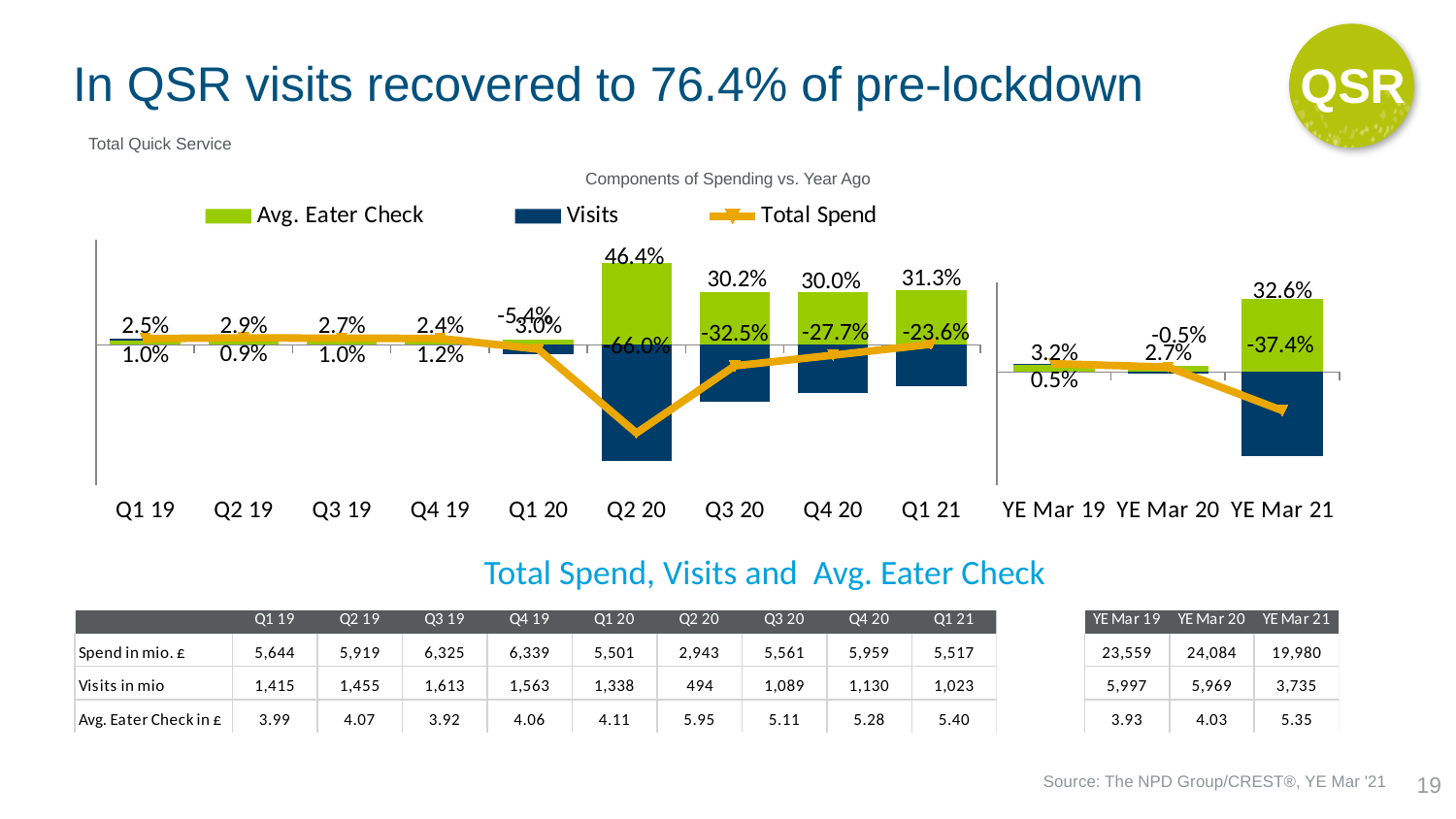
In the quarterly chart (Q1 19 to Q1 21), what is the Avg. Eater Check value for Q2 20? 46.4% How many quarters are shown on the x axis of the quarterly chart (Q1 19 to Q1 21)? 9 In the quarterly chart (Q1 19 to Q1 21), what is the Visits value for Q1 21? -23.6% In the quarterly chart (Q1 19 to Q1 21), what is the Visits value for Q2 20? -66.0% In the quarterly chart (Q1 19 to Q1 21), which quarter has the lowest Visits value? Q2 20 In the quarterly chart (Q1 19 to Q1 21), which quarter has the highest Avg. Eater Check value? Q2 20 In the yearly chart (YE Mar 19 to YE Mar 21), what is the Avg. Eater Check value for YE Mar 21? 32.6% In the quarterly chart (Q1 19 to Q1 21), what is the difference between the Avg. Eater Check values for Q1 21 and Q4 20? 1.3% In the quarterly chart (Q1 19 to Q1 21), is the Visits value for Q3 20 or Q4 20 higher? Q4 20 What is the title shown above the charts on this slide? Components of Spending vs. Year Ago In the yearly chart (YE Mar 19 to YE Mar 21), what is the Visits value for YE Mar 21? -37.4% How many series does the legend list for the charts on this slide? 3